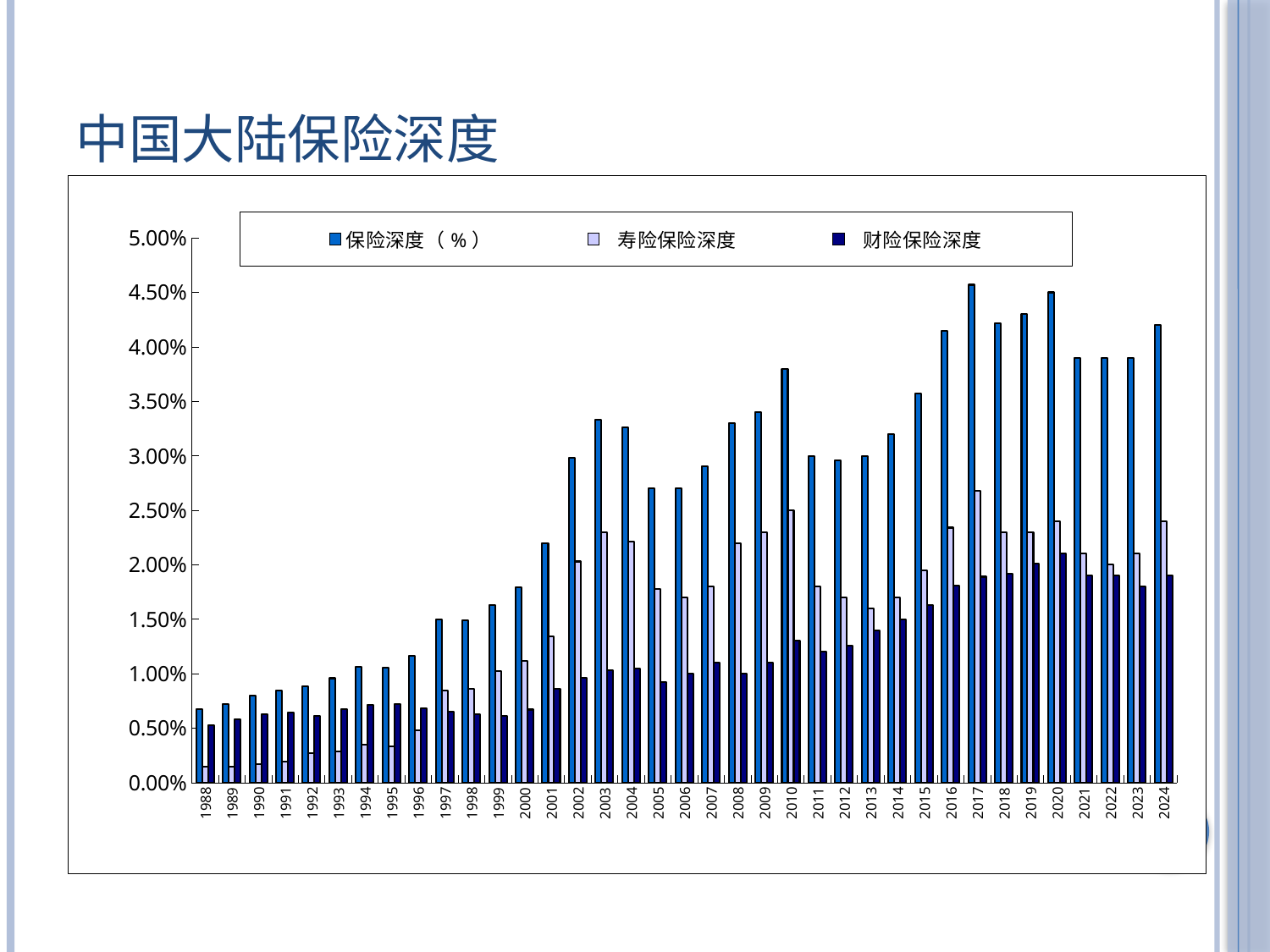
Which is larger, the 保险深度（%） value for 2017 or for 2021? 2017 Which year has the highest value for 保险深度（%）? 2017 What kind of chart is shown on the slide? bar chart Which is larger, the 寿险保险深度 value for 2010 or for 2011? 2010 Which year has the lowest value for 保险深度（%）? 1988 Is the value for 财险保险深度 in 2014 greater or less than 2.00%? less Is the value for 寿险保险深度 in 2001 greater or less than 1.50%? less How many years are shown on the x axis? 37 How many series does the legend list? 3 Does the value for 保险深度（%） rise or fall from 1988 to 2001? rise Is the value for 保险深度（%） in 2003 greater or less than 3.00%? greater